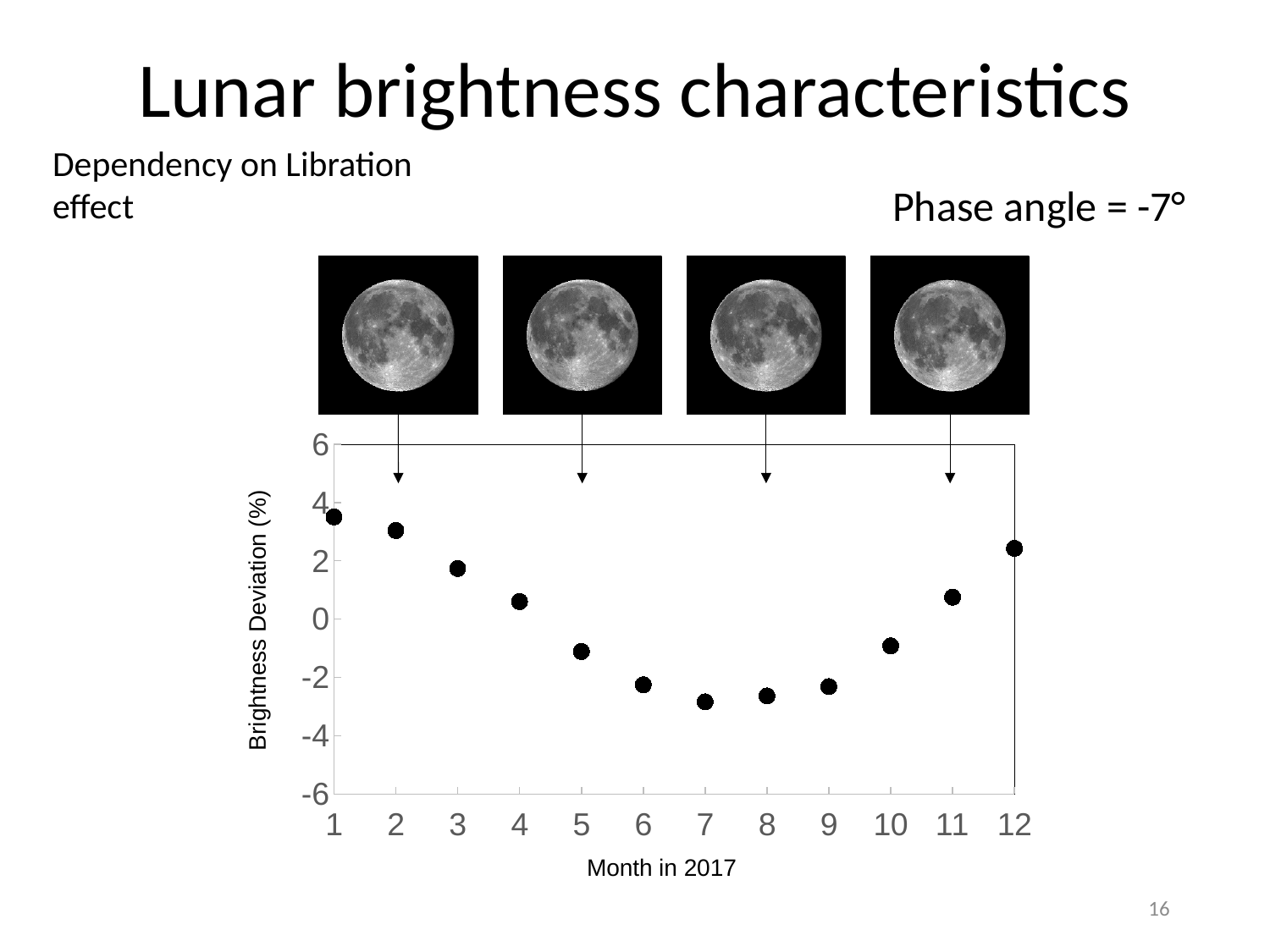
Which month has the lowest brightness deviation? 7 Is the brightness deviation for month 5 greater or less than 0%? less What is the label of the y axis? Brightness Deviation (%) What is the label of the x axis? Month in 2017 Which month has the highest brightness deviation? 1 Is the brightness deviation for month 7 greater or less than -2%? less Do the brightness deviation values rise or fall from month 1 to month 7? fall Which has a higher brightness deviation, month 2 or month 10? month 2 Is the brightness deviation for month 12 greater or less than 2%? greater What kind of chart is shown on the slide? scatter plot How many data points are plotted in the chart? 12